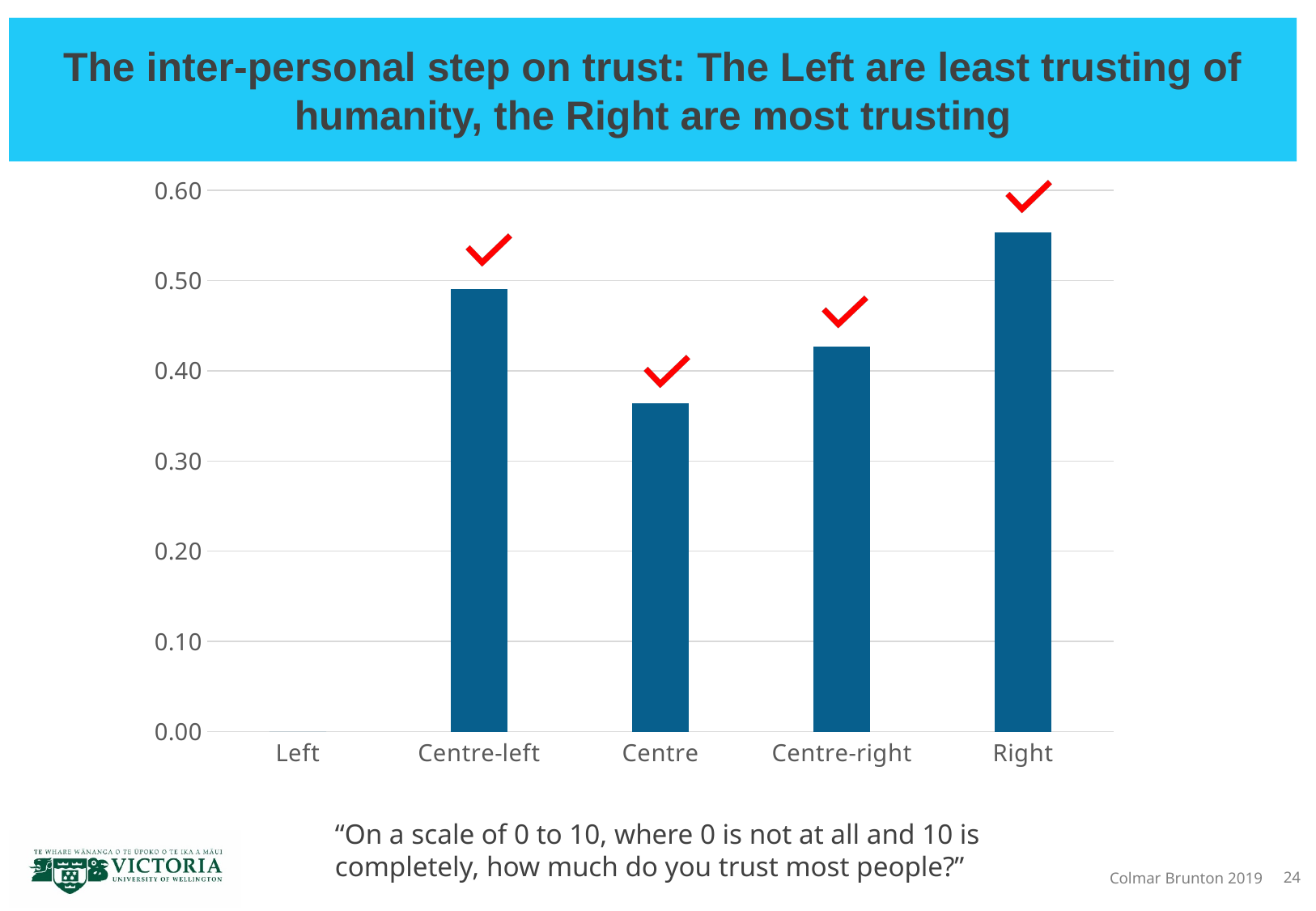
Is the value for Centre greater or less than 0.40? less Is the value for Centre-left greater or less than 0.40? greater What colour are the bars in the chart? blue What kind of chart is shown on the slide? bar chart What is the highest tick value shown on the y axis of the chart? 0.60 Which category has the tallest bar in the chart? Right Is the value for Centre-right greater or less than 0.50? less Which is larger, the value for Right or the value for Centre-left? Right Which is larger, the value for Centre or the value for Centre-right? Centre-right How many categories are labelled on the x axis of the chart? 5